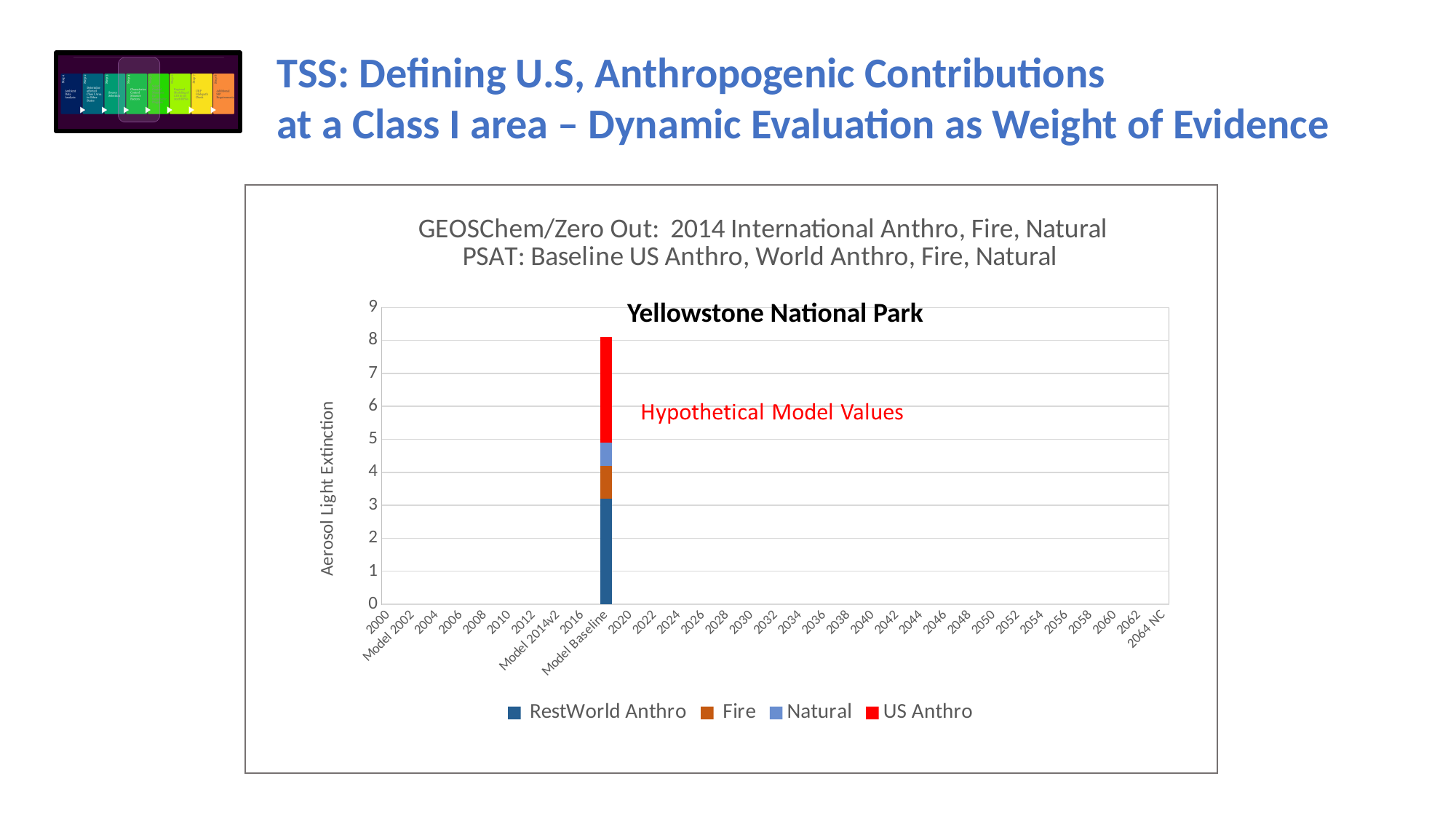
Is the RestWorld Anthro segment of the Model Baseline bar greater or less than 2? greater In the Model Baseline bar, which segment is larger: US Anthro or Fire? US Anthro Which x-axis category has a plotted bar? Model Baseline How many series does the chart legend list? 4 Which series are listed in the chart legend? RestWorld Anthro, Fire, Natural, US Anthro What kind of chart is shown on the slide? Stacked bar chart How many bars are plotted in the chart? 1 Is the total height of the Model Baseline stacked bar greater or less than 7? greater Which series is shown in red in the chart? US Anthro Is the Fire segment of the Model Baseline bar greater or less than 2? less What is the label on the vertical axis of the chart? Aerosol Light Extinction In the Model Baseline bar, which segment is larger: RestWorld Anthro or Natural? RestWorld Anthro